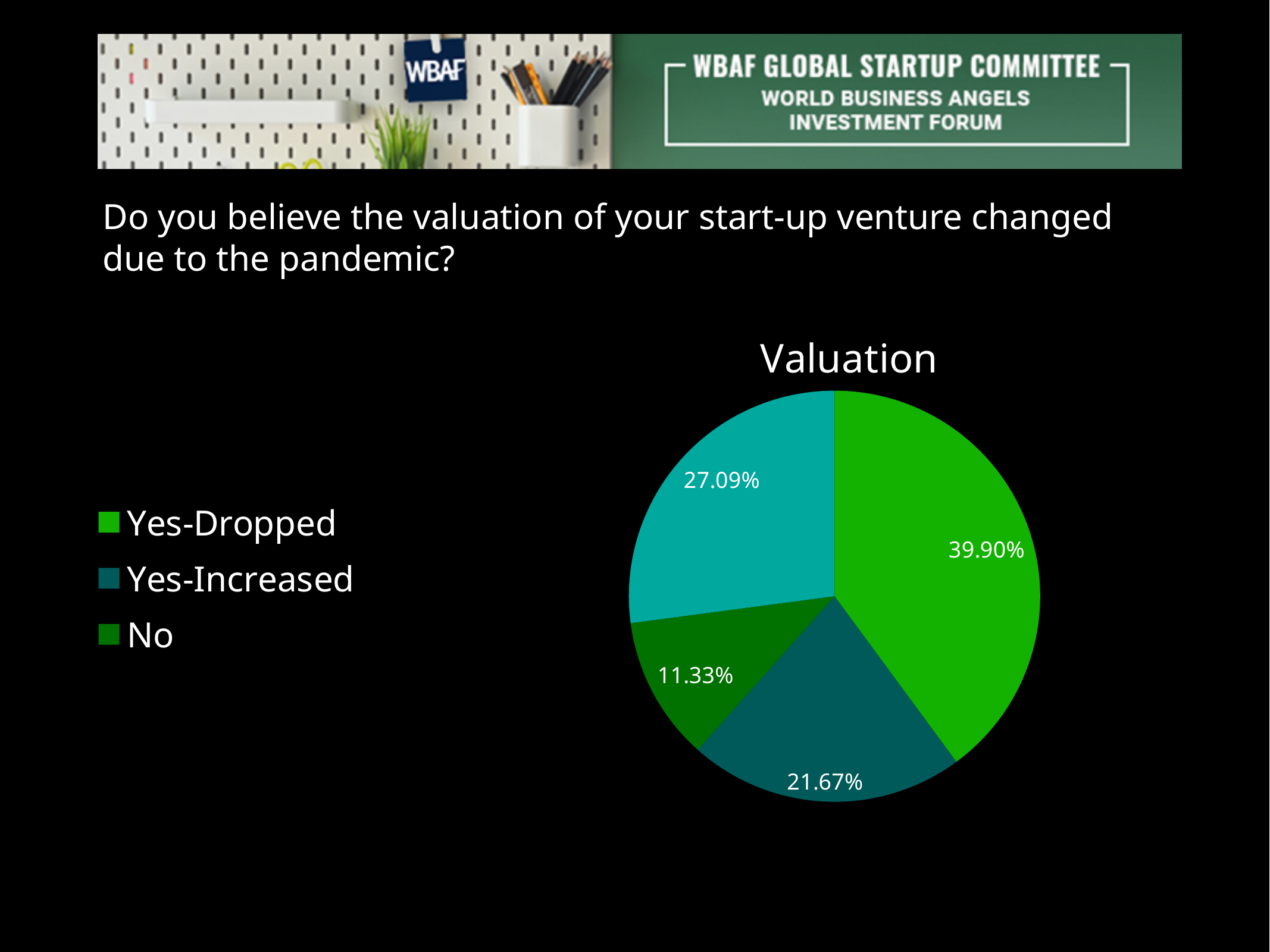
How many entries does the legend list? 3 What percentage of the pie is Yes-Increased? 21.67% What is the difference between the Yes-Dropped and Yes-Increased shares? 18.23% Which slice of the pie is the smallest? No Which slice of the pie is the largest? Yes-Dropped Which is larger, the Yes-Increased slice or the No slice? Yes-Increased What percentage of the pie is No? 11.33% What percentage of the pie is Yes-Dropped? 39.90% What is the difference between the Yes-Increased and No shares? 10.34% How many slices does the pie chart have? 4 What is the title of the chart? Valuation What kind of chart is shown on the slide? pie chart